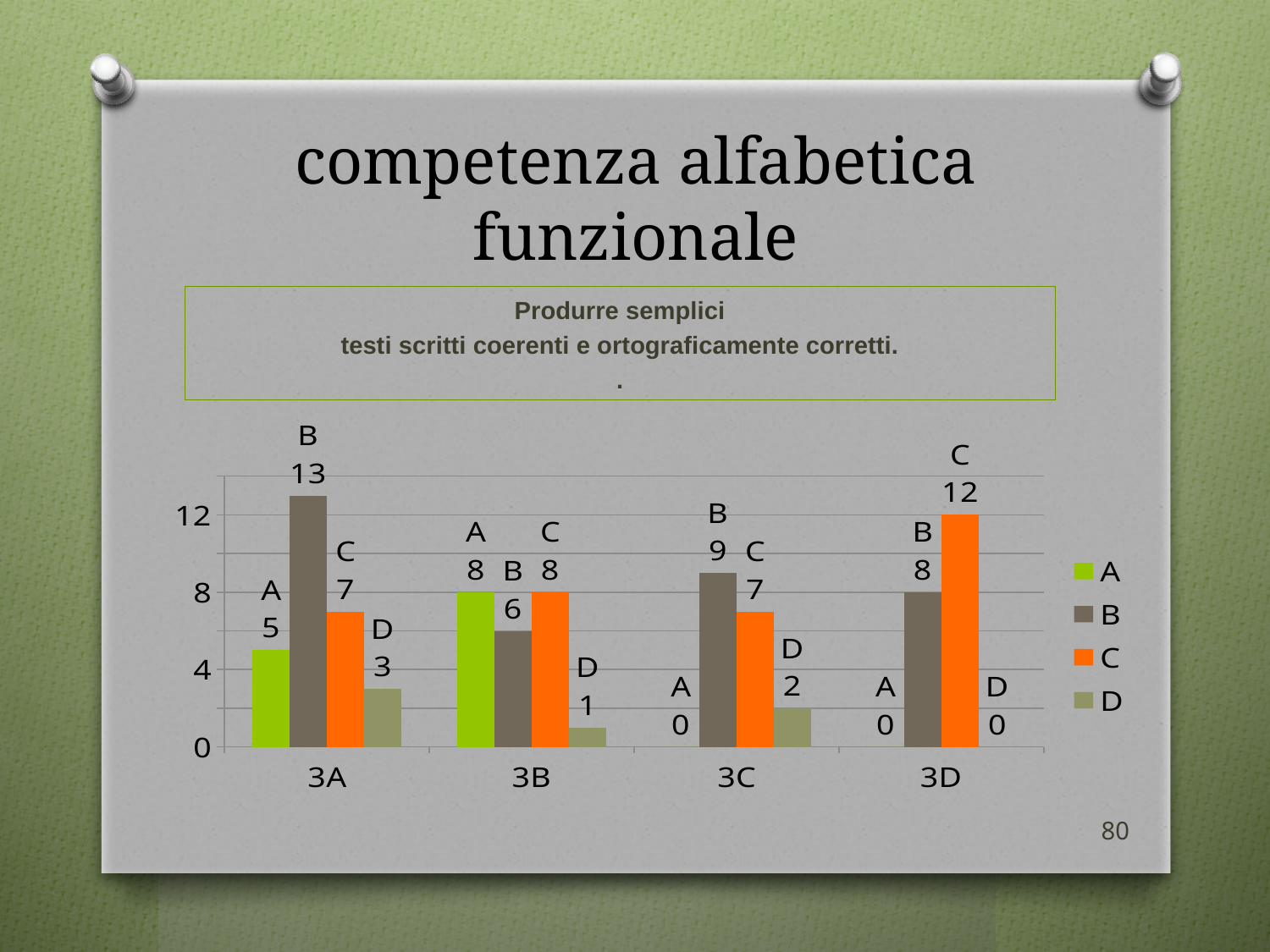
What kind of chart is shown on the slide? bar chart What is the value for series A in category 3C? 0 What is the difference between the values for series B and series A in category 3A? 8 What is the value for series C in category 3D? 12 Which category has the lowest value for series C? 3A and 3C (both 7) What colour represents series C in the legend? orange How many categories are shown on the x axis? 4 How many series does the legend list? 4 Which is larger in category 3B: the value for series A or the value for series B? A What is the value for series D in category 3B? 1 What is the value for series B in category 3A? 13 Which category has the highest value for series B? 3A